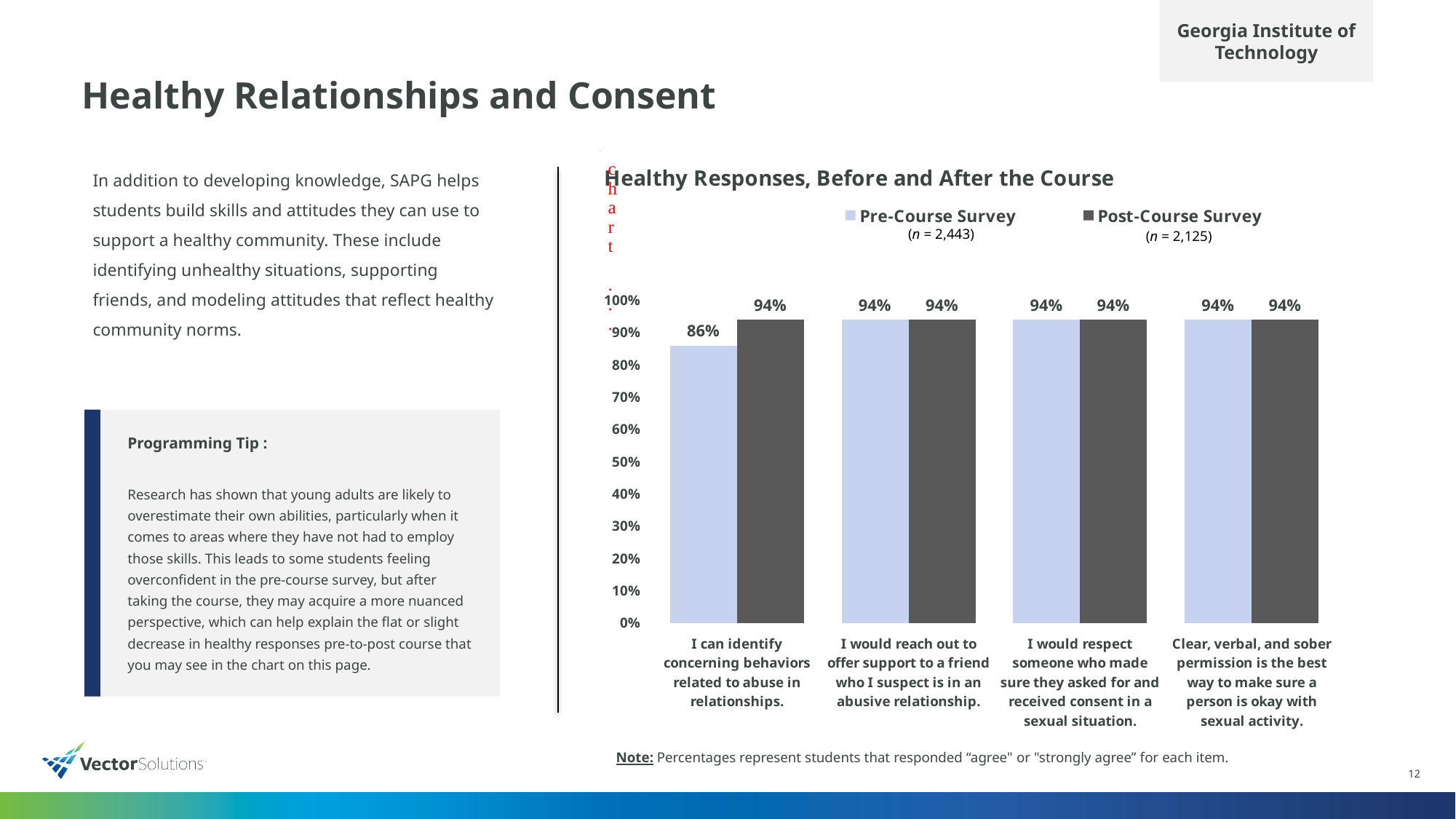
How many series does the chart legend list? 2 What is the Pre-Course Survey value for "Clear, verbal, and sober permission is the best way to make sure a person is okay with sexual activity"? 94% What type of chart is shown on the slide? Bar chart What is the sample size (n) shown for the Post-Course Survey in the legend? 2,125 What is the Pre-Course Survey value for "I can identify concerning behaviors related to abuse in relationships"? 86% What is the Post-Course Survey value for "I would reach out to offer support to a friend who I suspect is in an abusive relationship"? 94% What is the title of the chart? Healthy Responses, Before and After the Course What is the Post-Course Survey value for "I can identify concerning behaviors related to abuse in relationships"? 94% For "I can identify concerning behaviors related to abuse in relationships", which is larger: the Pre-Course Survey value or the Post-Course Survey value? Post-Course Survey What is the difference between the Post-Course and Pre-Course Survey values for "I can identify concerning behaviors related to abuse in relationships"? 8% How many categories are shown on the x axis of the chart? 4 Which category has the lowest Pre-Course Survey value? I can identify concerning behaviors related to abuse in relationships.